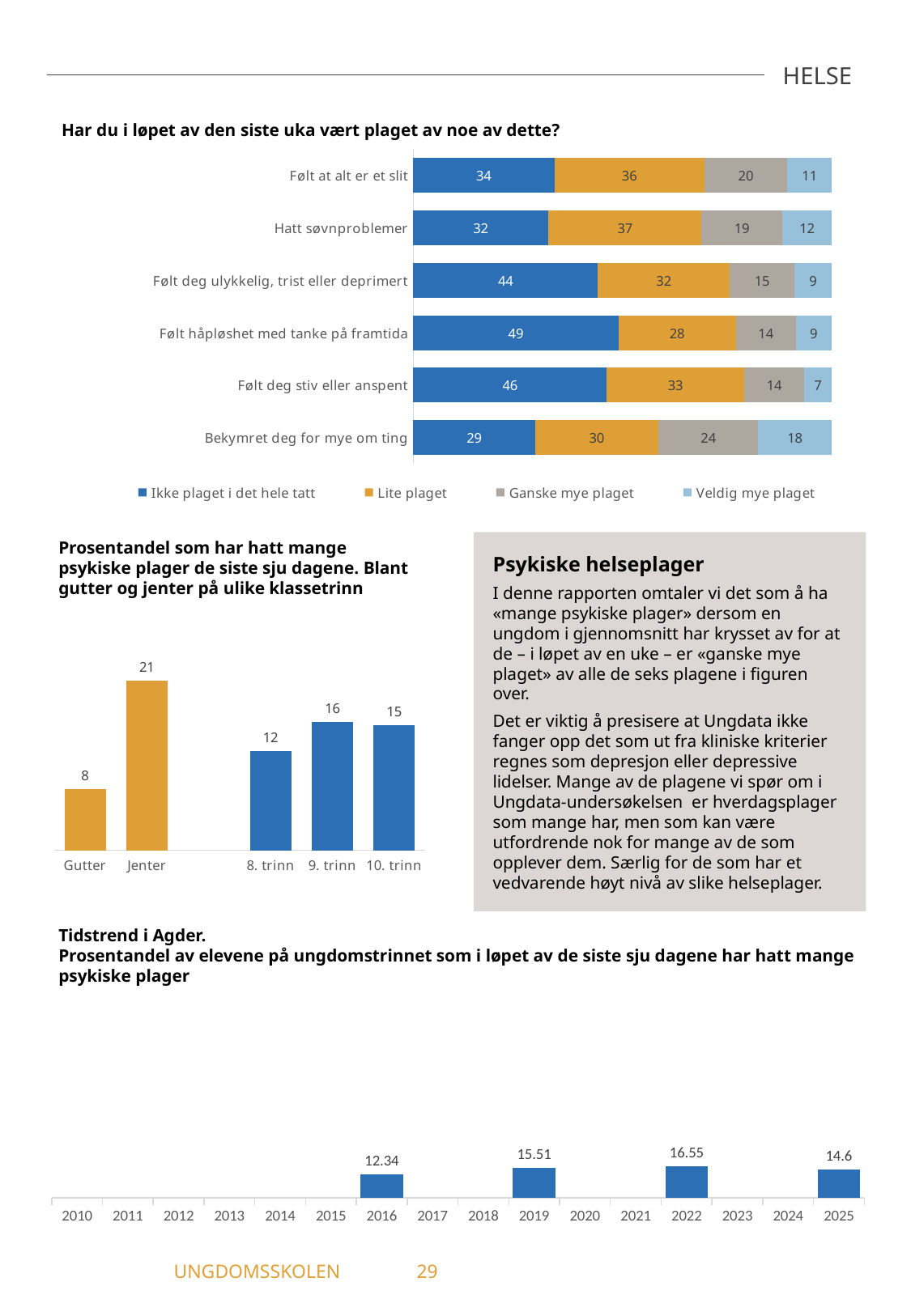
In the chart 'Tidstrend i Agder', which year has the highest value? 2022 What kind of chart is the 'Tidstrend i Agder' chart at the bottom of the slide? Bar chart In the chart 'Prosentandel som har hatt mange psykiske plager de siste sju dagene', what is the difference between '9. trinn' and '8. trinn'? 4 In the top chart 'Har du i løpet av den siste uka vært plaget av noe av dette?', which category has the highest value for 'Ganske mye plaget'? Bekymret deg for mye om ting In the top chart 'Har du i løpet av den siste uka vært plaget av noe av dette?', what is the difference between 'Lite plaget' for 'Hatt søvnproblemer' and 'Lite plaget' for 'Følt håpløshet med tanke på framtida'? 9 In the top chart 'Har du i løpet av den siste uka vært plaget av noe av dette?', what is the value of 'Ikke plaget i det hele tatt' for 'Følt håpløshet med tanke på framtida'? 49 In the chart 'Prosentandel som har hatt mange psykiske plager de siste sju dagene', which category has the lowest value? Gutter In the chart 'Prosentandel som har hatt mange psykiske plager de siste sju dagene', what is the value for 'Jenter'? 21 In the top chart 'Har du i løpet av den siste uka vært plaget av noe av dette?', what is the value of 'Veldig mye plaget' for 'Bekymret deg for mye om ting'? 18 In the chart 'Tidstrend i Agder', what is the value for 2022? 16.55 In the top chart 'Har du i løpet av den siste uka vært plaget av noe av dette?', how many series does the legend list? 4 In the top chart 'Har du i løpet av den siste uka vært plaget av noe av dette?', how many categories are shown? 6